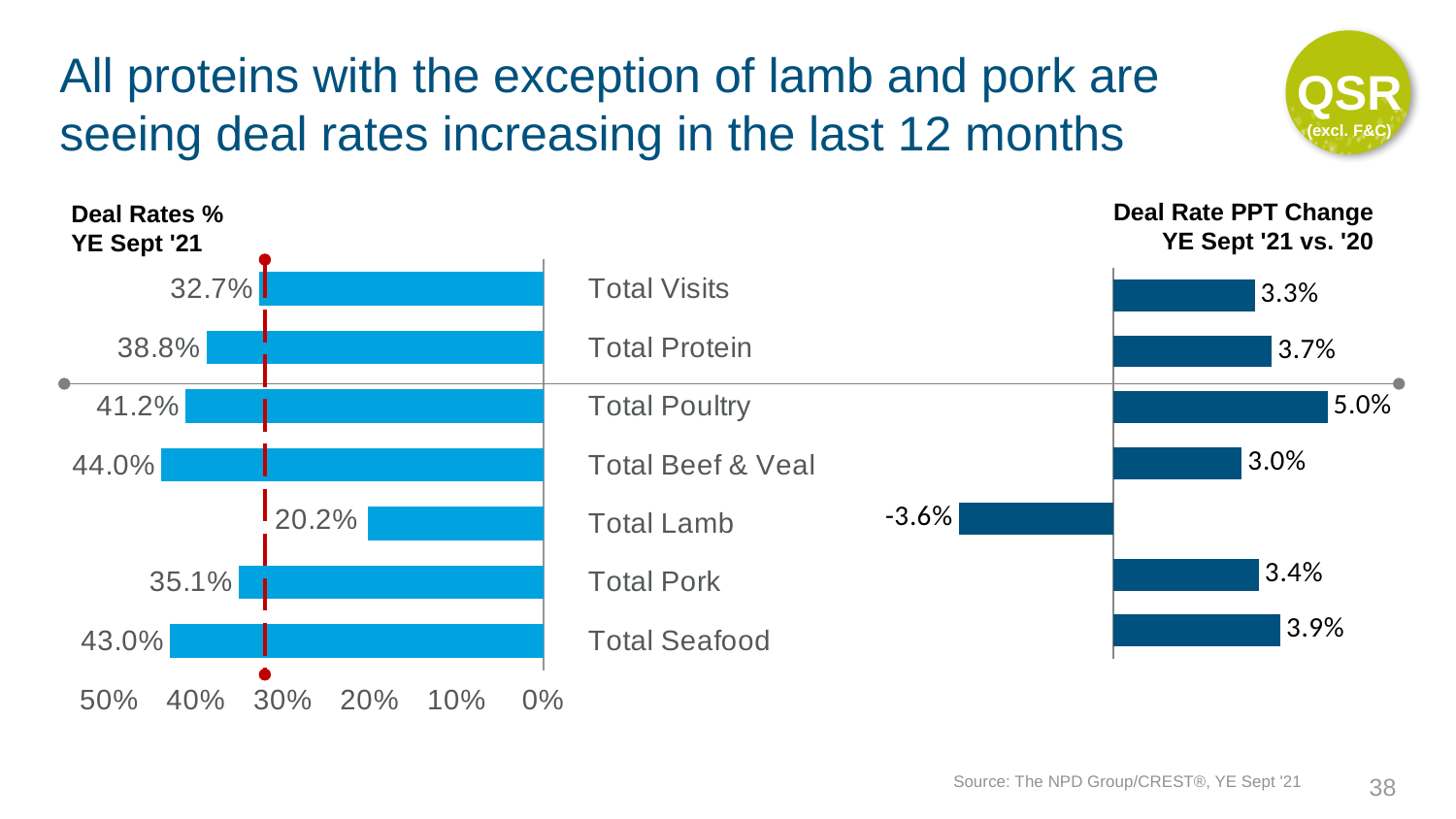
In the Deal Rate PPT Change YE Sept '21 vs. '20 chart, how many categories have a negative value? 1 In the Deal Rate PPT Change YE Sept '21 vs. '20 chart, which is larger, the value for Total Protein or the value for Total Visits? Total Protein In the Deal Rate PPT Change YE Sept '21 vs. '20 chart, which category has the lowest value? Total Lamb What kind of chart is the Deal Rate PPT Change YE Sept '21 vs. '20 chart? Bar chart In the Deal Rates % YE Sept '21 chart, what is the difference between the deal rates for Total Seafood and Total Pork? 7.9% In the Deal Rates % YE Sept '21 chart, what is the deal rate for Total Lamb? 20.2% How many categories are shown in the Deal Rates % YE Sept '21 chart? 7 In the Deal Rates % YE Sept '21 chart, is the value for Total Poultry greater or less than 40%? greater In the Deal Rates % YE Sept '21 chart, what is the deal rate for Total Beef & Veal? 44.0% In the Deal Rates % YE Sept '21 chart, which category has the highest deal rate? Total Beef & Veal In the Deal Rate PPT Change YE Sept '21 vs. '20 chart, what is the value for Total Seafood? 3.9% In the Deal Rate PPT Change YE Sept '21 vs. '20 chart, what is the value for Total Poultry? 5.0%